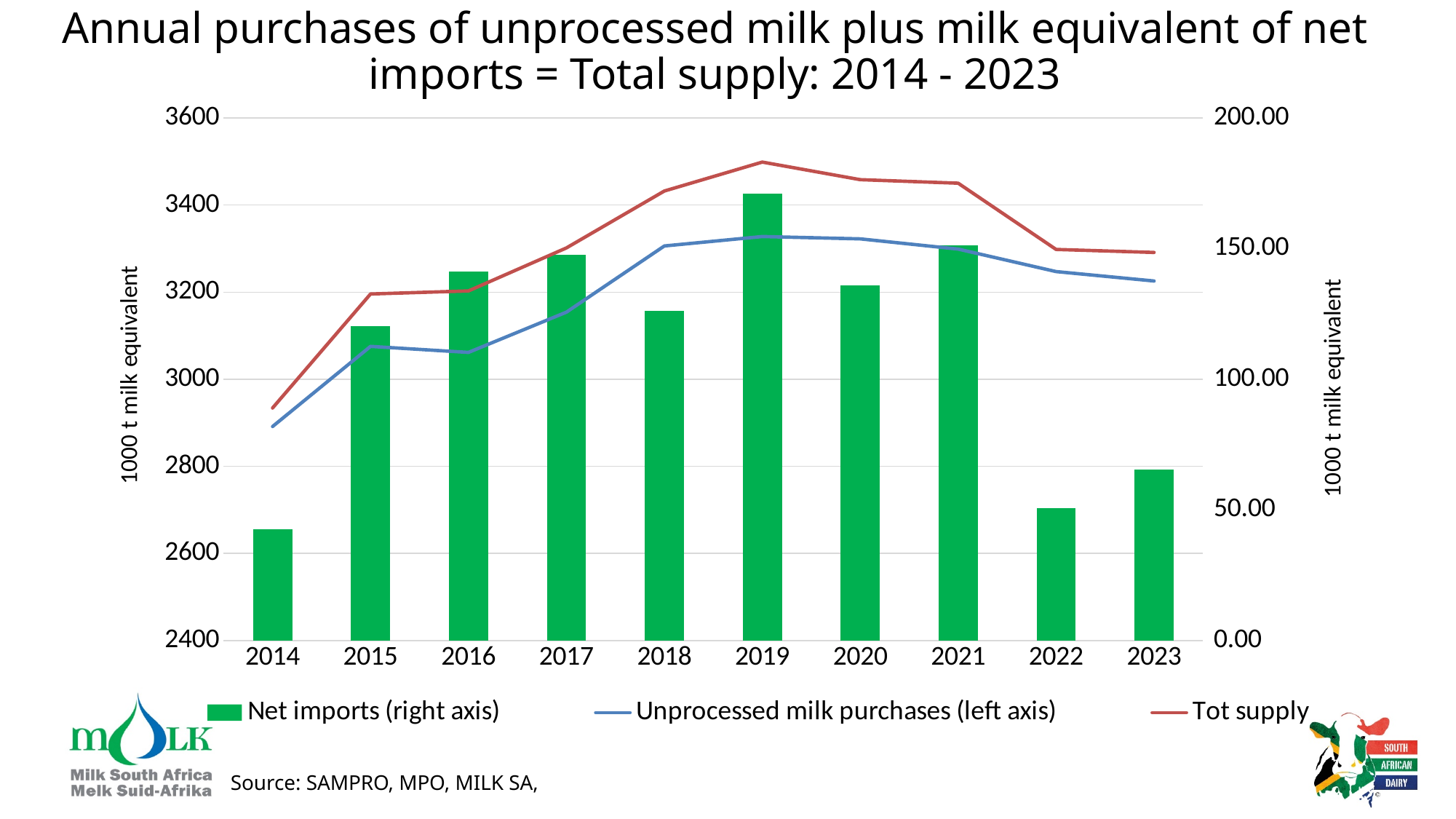
Which year has the lowest Net imports bar? 2014 Is the Net imports value for 2019 greater or less than 150.00 on the right axis? greater How many years are shown on the x axis? 10 Is the Net imports value for 2022 greater or less than 100.00 on the right axis? less Which year has the highest Net imports bar? 2019 Is the Tot supply value for 2019 greater or less than 3400 on the left axis? greater How many series does the legend list? 3 Does the Tot supply line rise or fall from 2014 to 2019? rise Which year has the larger Net imports bar, 2019 or 2022? 2019 In which year is the Unprocessed milk purchases line at its lowest? 2014 In which year does the Tot supply line reach its highest point? 2019